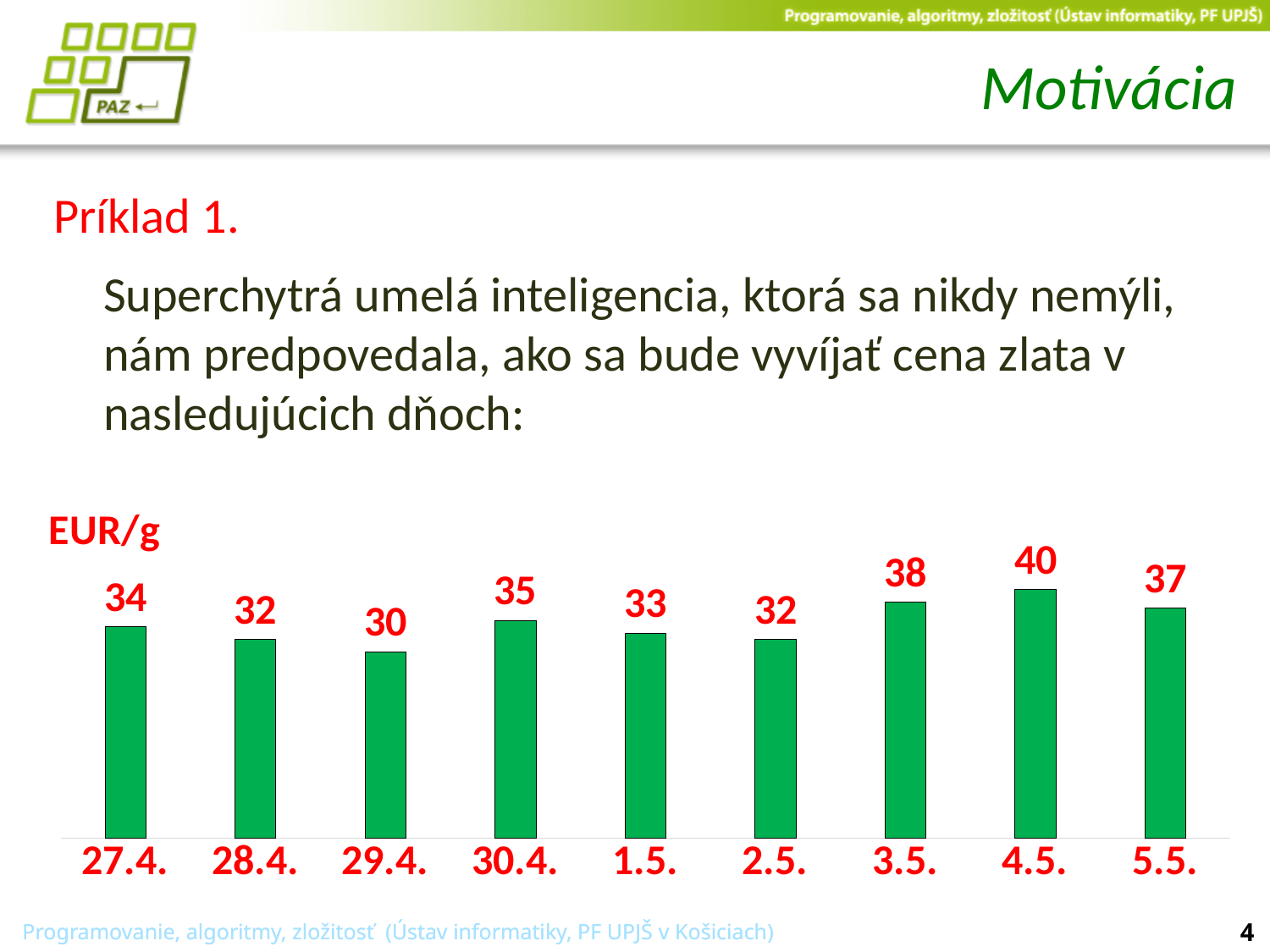
Which date has the highest value? 4.5. Which is larger, the value for 28.4. or the value for 5.5.? 5.5. How many dates are shown on the x axis? 9 What kind of chart is shown on the slide? bar chart What is the value for 3.5.? 38 What unit is shown above the chart? EUR/g What is the difference between the values for 4.5. and 29.4.? 10 What is the value for 29.4.? 30 Do the values rise or fall from 1.5. to 4.5.? They fall from 1.5. to 2.5., then rise to 4.5. Which date has the lowest value? 29.4. What is the difference between the values for 30.4. and 1.5.? 2 What is the value for 27.4.? 34